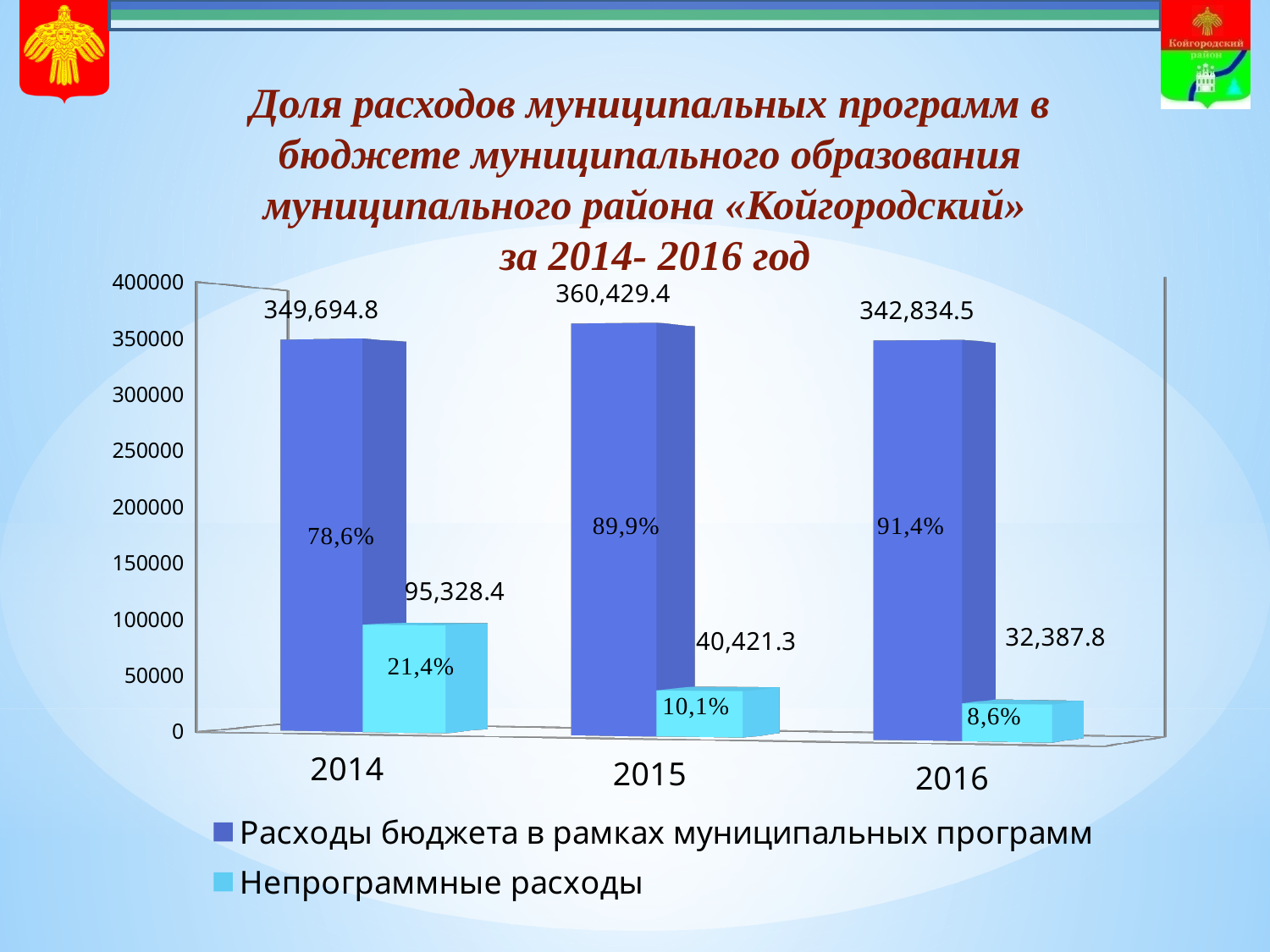
In which year is Расходы бюджета в рамках муниципальных программ highest? 2015 Which is larger: Расходы бюджета в рамках муниципальных программ in 2014 or in 2016? 2014 What is the value for Расходы бюджета в рамках муниципальных программ in 2015? 360,429.4 How many series does the legend list? 2 What is the value for Непрограммные расходы in 2014? 95,328.4 In which year is Непрограммные расходы lowest? 2016 Do the values for Непрограммные расходы rise or fall from 2014 to 2016? fall What kind of chart is shown on the slide? bar chart What percentage share is shown on the Расходы бюджета в рамках муниципальных программ bar for 2016? 91,4% What percentage share is shown on the Непрограммные расходы bar for 2015? 10,1% What is the difference between Непрограммные расходы in 2014 and in 2015? 54,907.1 What is the value for Непрограммные расходы in 2016? 32,387.8